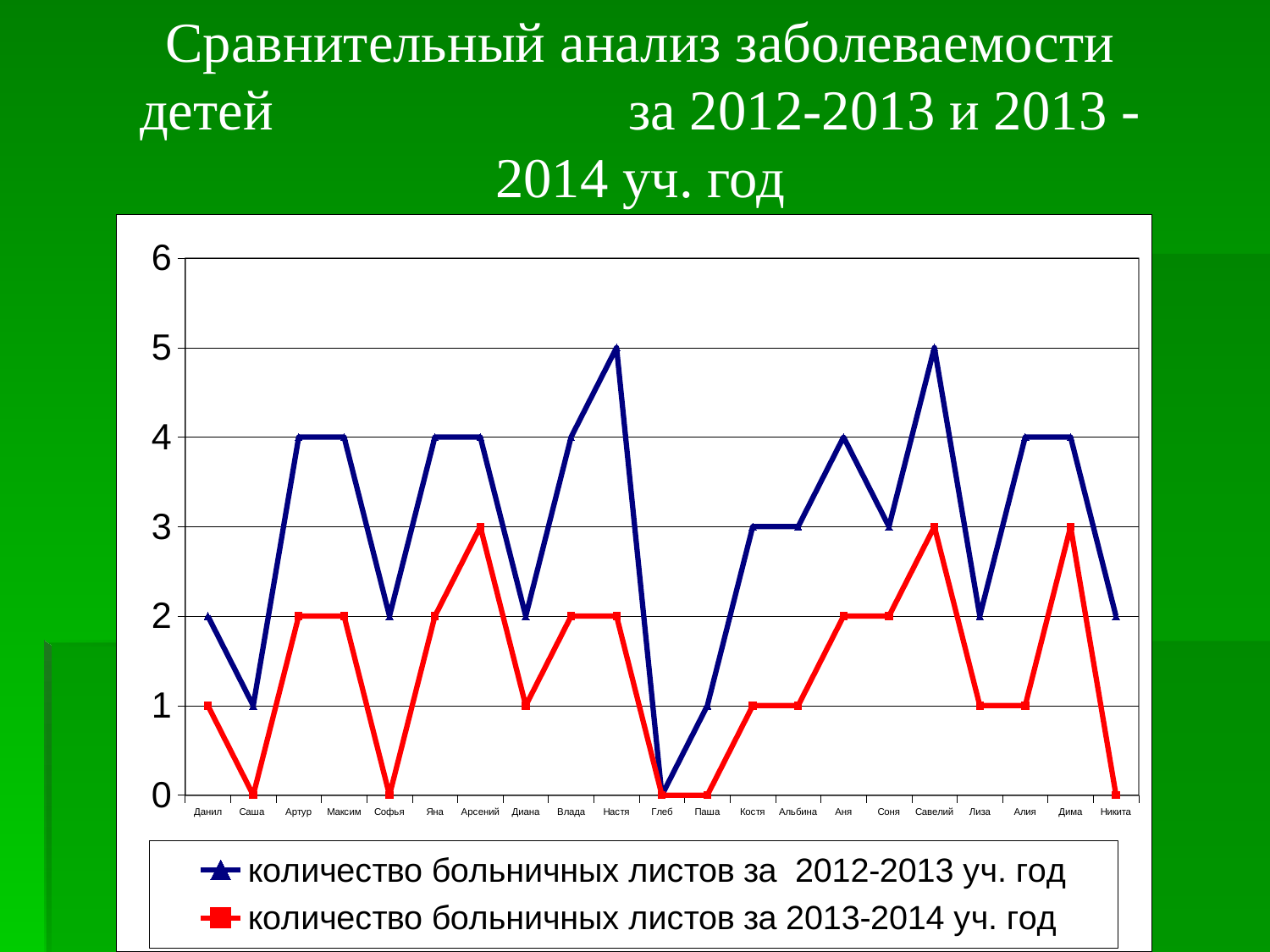
Which child has the lowest value in the series 'количество больничных листов за 2012-2013 уч. год'? Глеб What is the value for Настя in the series 'количество больничных листов за 2012-2013 уч. год'? 5 What is the value for Арсений in the series 'количество больничных листов за 2013-2014 уч. год'? 3 How many children (categories) are shown along the x axis? 21 How many series does the legend list? 2 What is the difference between the 2012-2013 value and the 2013-2014 value for Савелий? 2 Which colour is used for the series 'количество больничных листов за 2013-2014 уч. год'? red For Дима, which series has the larger value: 2012-2013 or 2013-2014? 2012-2013 What kind of chart is shown on the slide? line chart What is the value for Глеб in the series 'количество больничных листов за 2012-2013 уч. год'? 0 Is the value for Влада in the 2012-2013 series greater or less than 3? greater What is the value for Никита in the series 'количество больничных листов за 2013-2014 уч. год'? 0